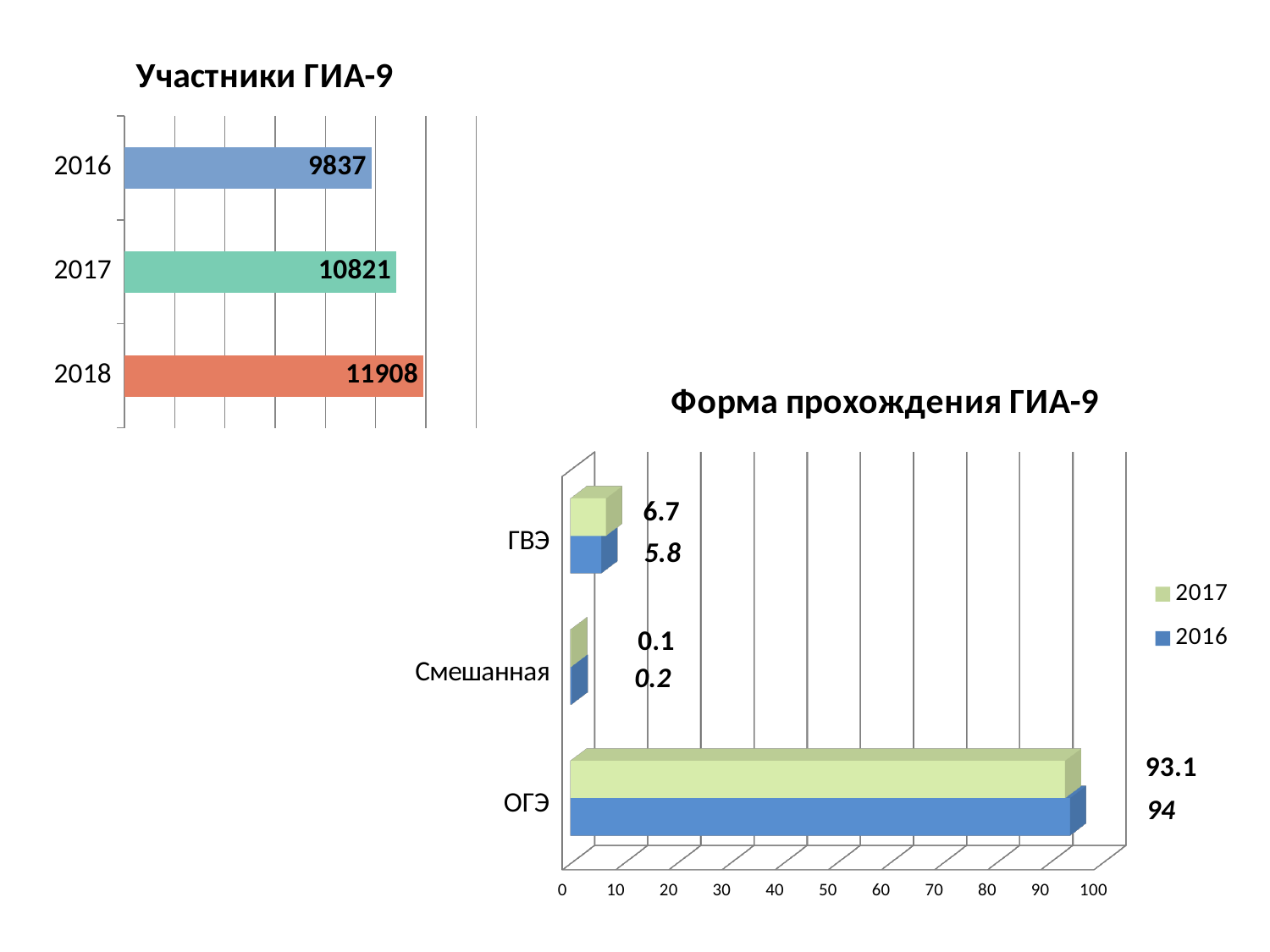
In the chart titled 'Форма прохождения ГИА-9', how many series does the legend list? 2 In the chart titled 'Участники ГИА-9', which year has the lowest value? 2016 In the chart titled 'Участники ГИА-9', how many bars are plotted? 3 In the chart titled 'Форма прохождения ГИА-9', what is the 2016 value for ОГЭ? 94 In the chart titled 'Форма прохождения ГИА-9', which category has the highest 2017 value? ОГЭ In the chart titled 'Форма прохождения ГИА-9', what is the 2017 value for ГВЭ? 6.7 In the chart titled 'Форма прохождения ГИА-9', which is larger for Смешанная: the 2016 value or the 2017 value? 2016 What kind of chart is 'Форма прохождения ГИА-9'? bar chart In the chart titled 'Участники ГИА-9', do the values rise or fall from 2016 to 2018? rise In the chart titled 'Участники ГИА-9', what is the difference between the 2018 and 2017 values? 1087 In the chart titled 'Участники ГИА-9', what is the value for 2018? 11908 In the chart titled 'Участники ГИА-9', what is the value for 2016? 9837